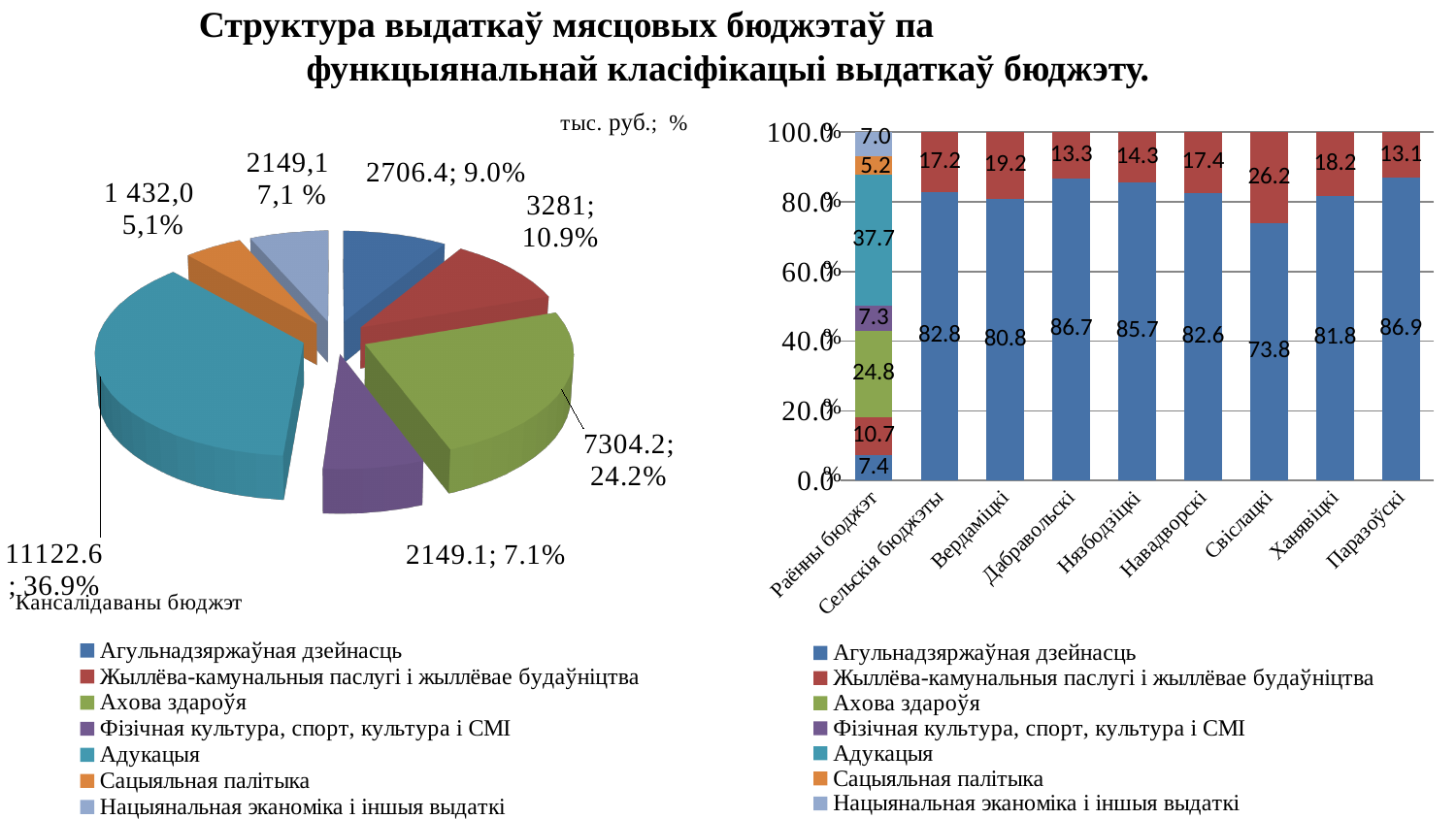
In the stacked bar chart on the right, which category has the largest red segment? Свіслацкі In the stacked bar chart on the right, what is the value of the red segment for Вердаміцкі? 19.2 In the pie chart on the left, what share does Адукацыя have? 36.9% In the stacked bar chart on the right, what is the value of the blue segment for Свіслацкі? 73.8 What type of chart is shown on the right side of the slide? Stacked bar chart In the pie chart on the left, what value is shown for Ахова здароўя? 7304.2; 24.2% In the stacked bar chart on the right, what is the value of the Адукацыя segment for Раённы бюджэт? 37.7 In the stacked bar chart on the right, how many categories are shown on the x axis? 9 In the pie chart on the left, how many entries does the legend list? 7 In the pie chart on the left, which category has the smallest slice? Сацыяльная палітыка In the pie chart on the left, which category has the largest slice? Адукацыя In the stacked bar chart on the right, what is the difference between the blue segment values for Паразоўскі and Свіслацкі? 13.1